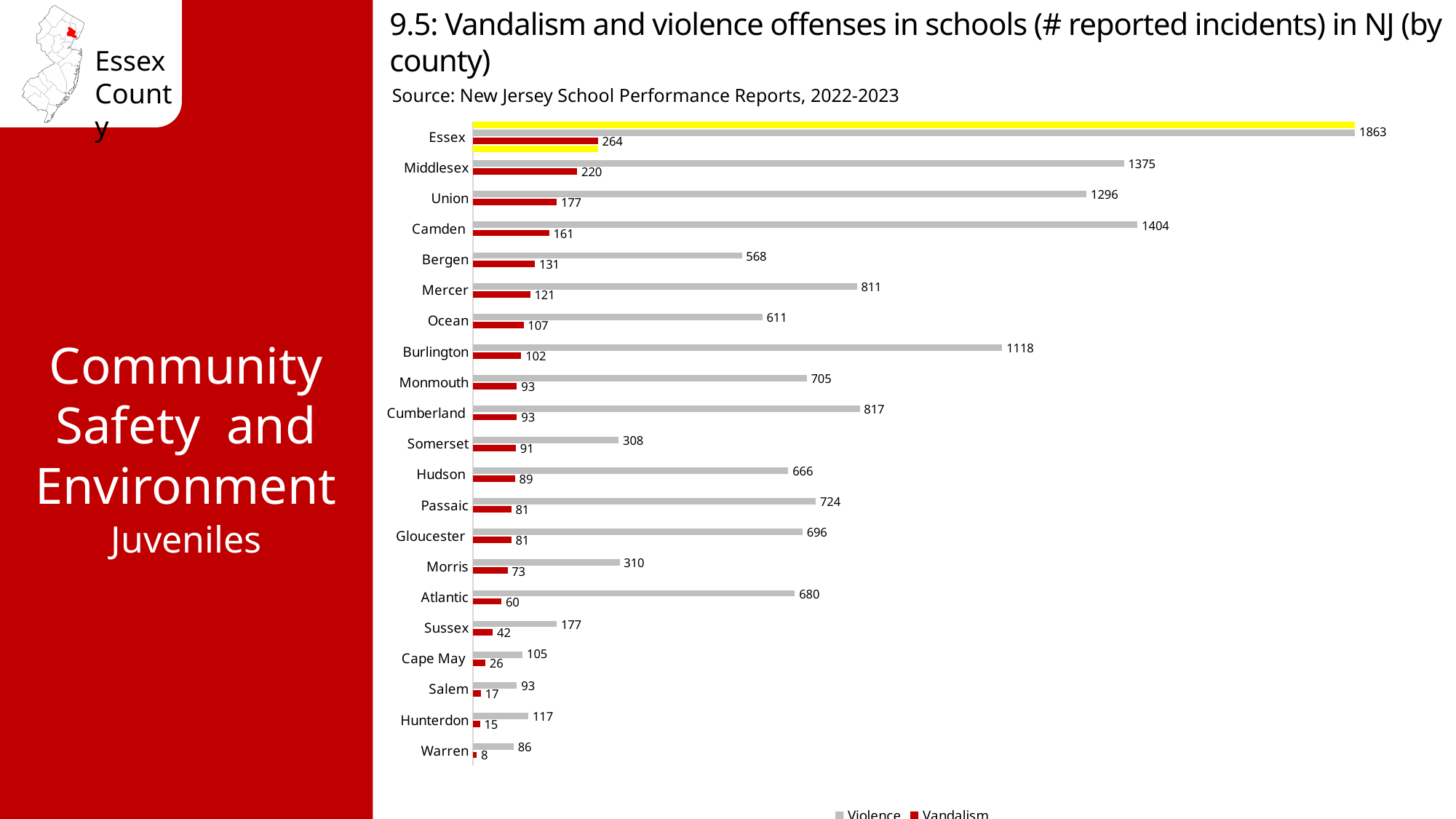
What kind of chart is shown on the slide? Bar chart What is the number of reported vandalism incidents in Middlesex County? 220 Which county has more reported violence incidents, Burlington or Mercer? Burlington What is the total of violence and vandalism incidents reported for Essex County? 2127 How many counties are shown on the chart? 21 What is the number of reported violence incidents in Essex County? 1863 Which county has the lowest number of reported vandalism incidents? Warren What is the difference between the violence incidents in Camden and Union? 108 Which colour represents the Vandalism series in the chart? Red How many series does the legend list? 2 Which county has the highest number of reported violence incidents? Essex What is the number of reported violence incidents in Cape May County? 105